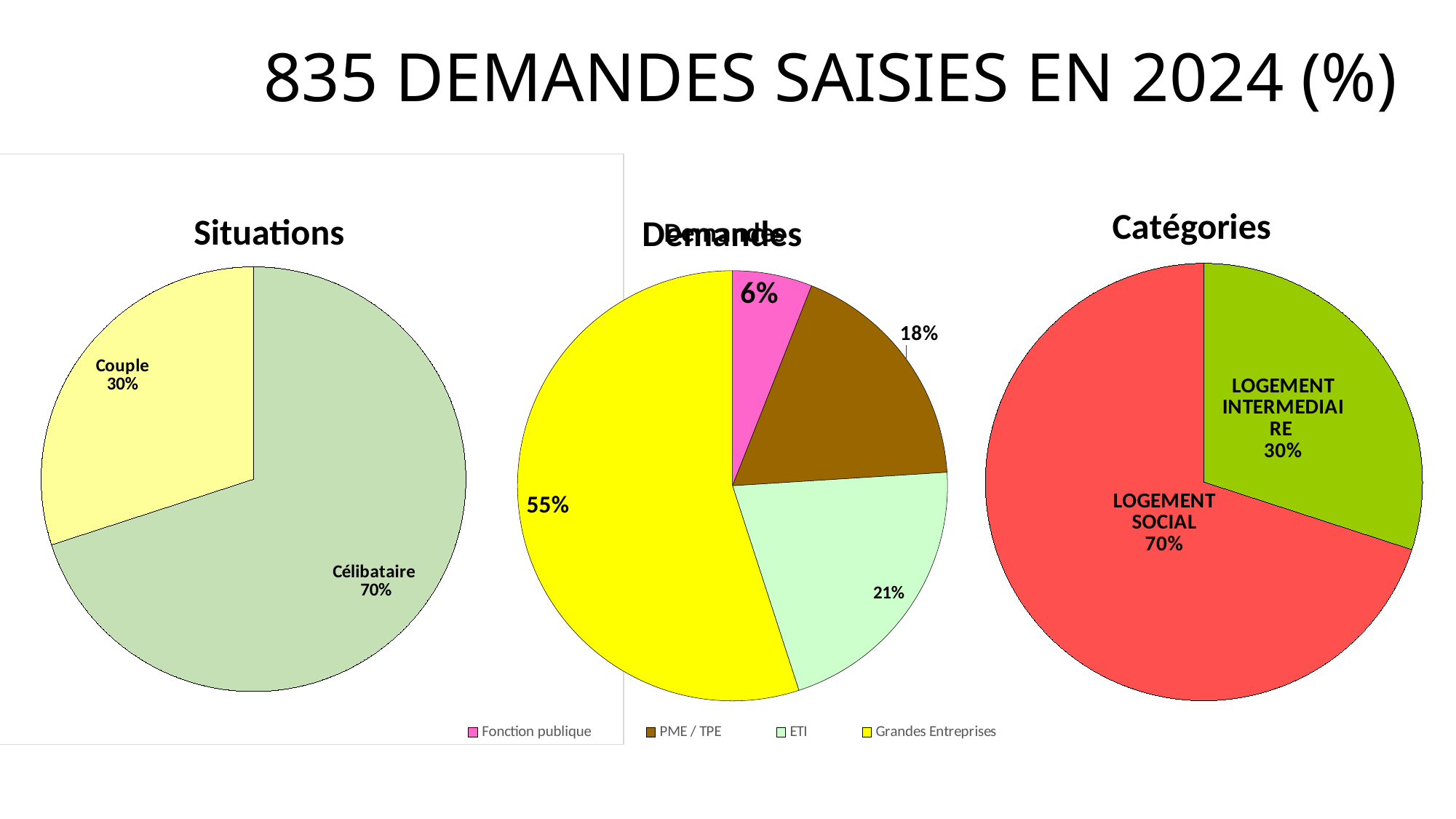
In the Catégories chart, what percentage is LOGEMENT SOCIAL? 70% In the middle chart (Demandes), what percentage is Fonction publique? 6% In the Situations chart, what percentage is Couple? 30% In the Situations chart, which category has the largest share? Célibataire What type of chart is the Catégories chart? Pie chart In the middle chart (Demandes), what is the difference between the ETI share and the PME / TPE share? 3% In the middle chart (Demandes), what percentage is Grandes Entreprises? 55% In the middle chart (Demandes), what percentage is ETI? 21% In the Situations chart, what percentage is Célibataire? 70% In the Catégories chart, which is larger, LOGEMENT SOCIAL or LOGEMENT INTERMEDIAIRE? LOGEMENT SOCIAL In the middle chart (Demandes), which category has the smallest share? Fonction publique How many entries does the legend of the middle chart (Demandes) list? 4